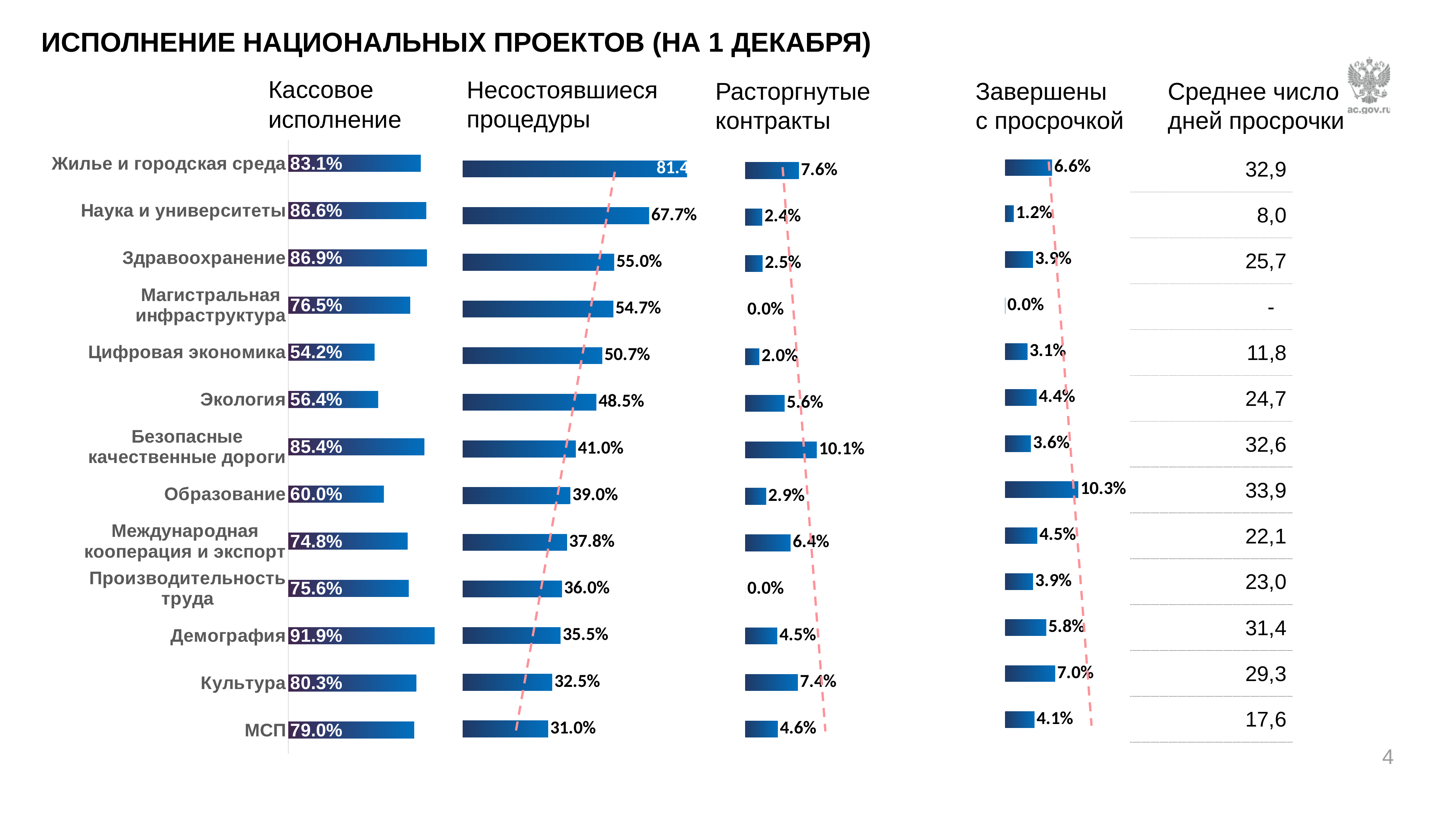
In the 'Завершены с просрочкой' chart, what is the difference between Жилье и городская среда and Наука и университеты? 5.4% In the 'Кассовое исполнение' chart, which category has the lowest value? Цифровая экономика In the 'Несостоявшиеся процедуры' chart, do the values rise or fall going down the list from Жилье и городская среда to МСП? fall In the 'Несостоявшиеся процедуры' chart, what is the value for Здравоохранение? 55.0% In the 'Кассовое исполнение' chart, which is larger: Экология or Образование? Образование In the 'Кассовое исполнение' chart, what is the value for Демография? 91.9% In the 'Расторгнутые контракты' chart, which category has the highest value? Безопасные качественные дороги In the 'Несостоявшиеся процедуры' chart, which category has the lowest value? МСП In the 'Завершены с просрочкой' chart, which category has the highest value? Образование In the 'Кассовое исполнение' chart, which category has the highest value? Демография How many categories are shown in the 'Кассовое исполнение' chart? 13 In the 'Расторгнутые контракты' chart, what is the value for Культура? 7.4%